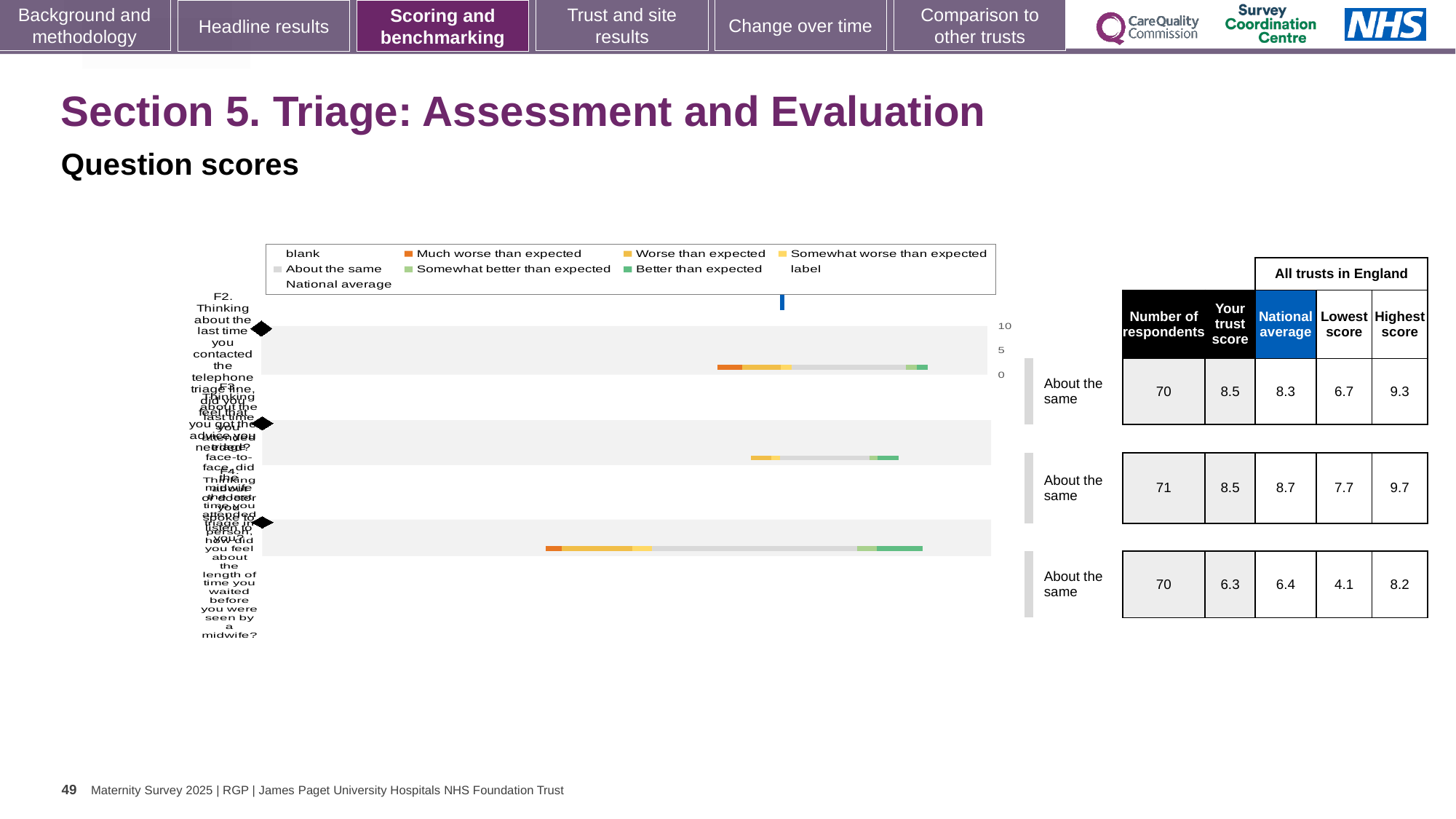
In the table next to the chart, what is the 'National average' for the first row? 8.3 In the first row of the table, which is larger: 'Your trust score' or 'National average'? Your trust score How many horizontal bars (questions) are plotted in the chart? 3 In the table next to the chart, which row has the highest 'Highest score' value? the second row (9.7) In the table next to the chart, what is the 'Your trust score' for the first row? 8.5 In the table next to the chart, what is the 'Number of respondents' for the second row? 71 In the table next to the chart, which row has the lowest 'Your trust score'? the third row (6.3) In the table next to the chart, what is the difference between the 'National average' and 'Your trust score' in the third row? 0.1 What kind of chart is shown on the slide? bar chart In the table next to the chart, what is the 'Lowest score' for the third row? 4.1 What colour does the legend use for 'Much worse than expected'? orange What colour does the legend use for 'Better than expected'? green